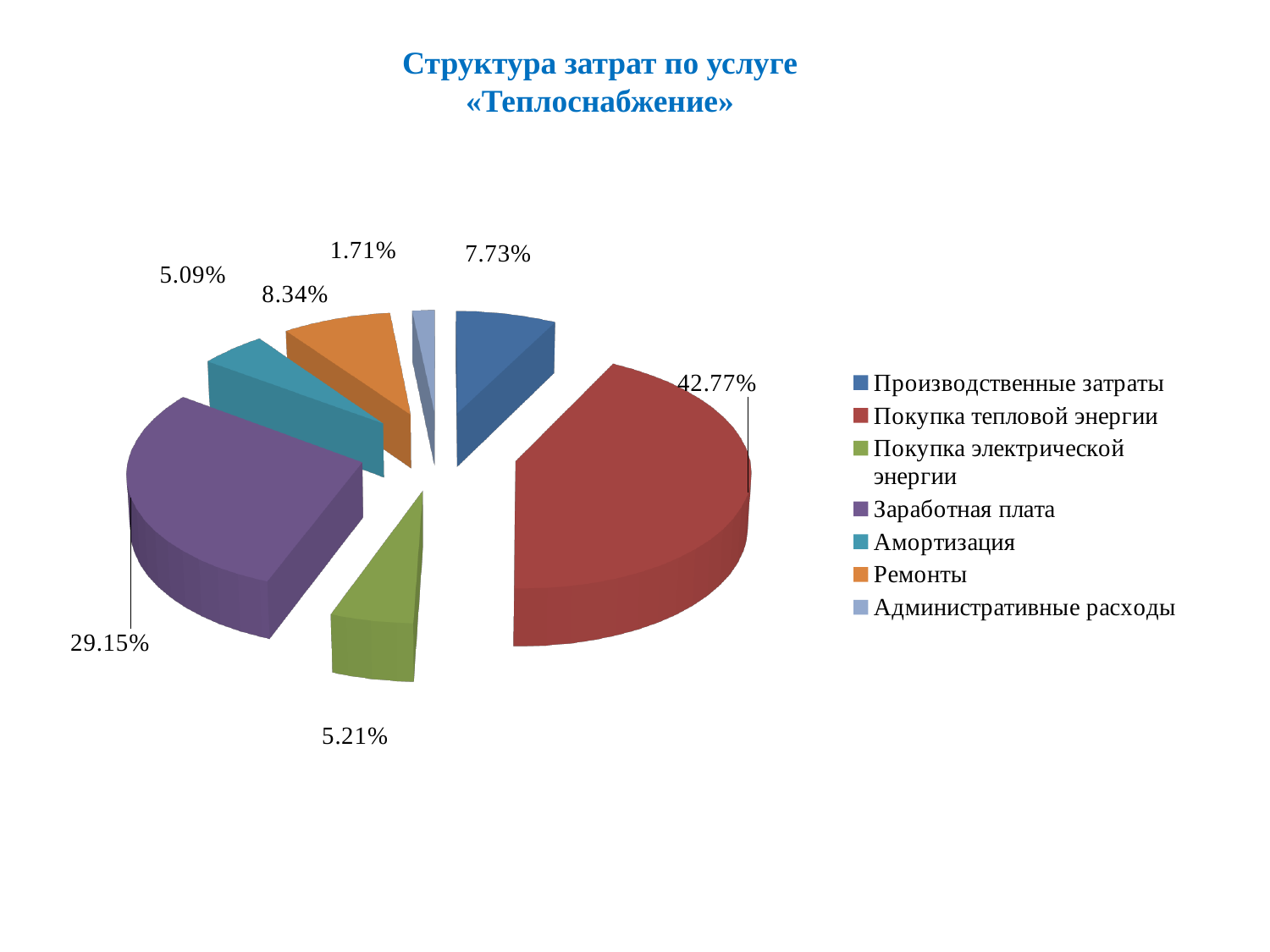
What share of costs does Покупка тепловой энергии account for? 42.77% What is the difference between the shares of Покупка тепловой энергии and Заработная плата? 13.62% What is the value shown for Заработная плата? 29.15% Which is larger, the share for Производственные затраты or the share for Ремонты? Ремонты What is the value for Административные расходы? 1.71% What percentage is shown for Ремонты? 8.34% How many categories does the pie chart show? 7 Which category has the smallest share of the pie? Административные расходы What is the title of the chart? Структура затрат по услуге «Теплоснабжение» What type of chart is shown on the slide? Pie chart Which colour represents Амортизация in the legend? Teal Which category has the largest share of the pie? Покупка тепловой энергии